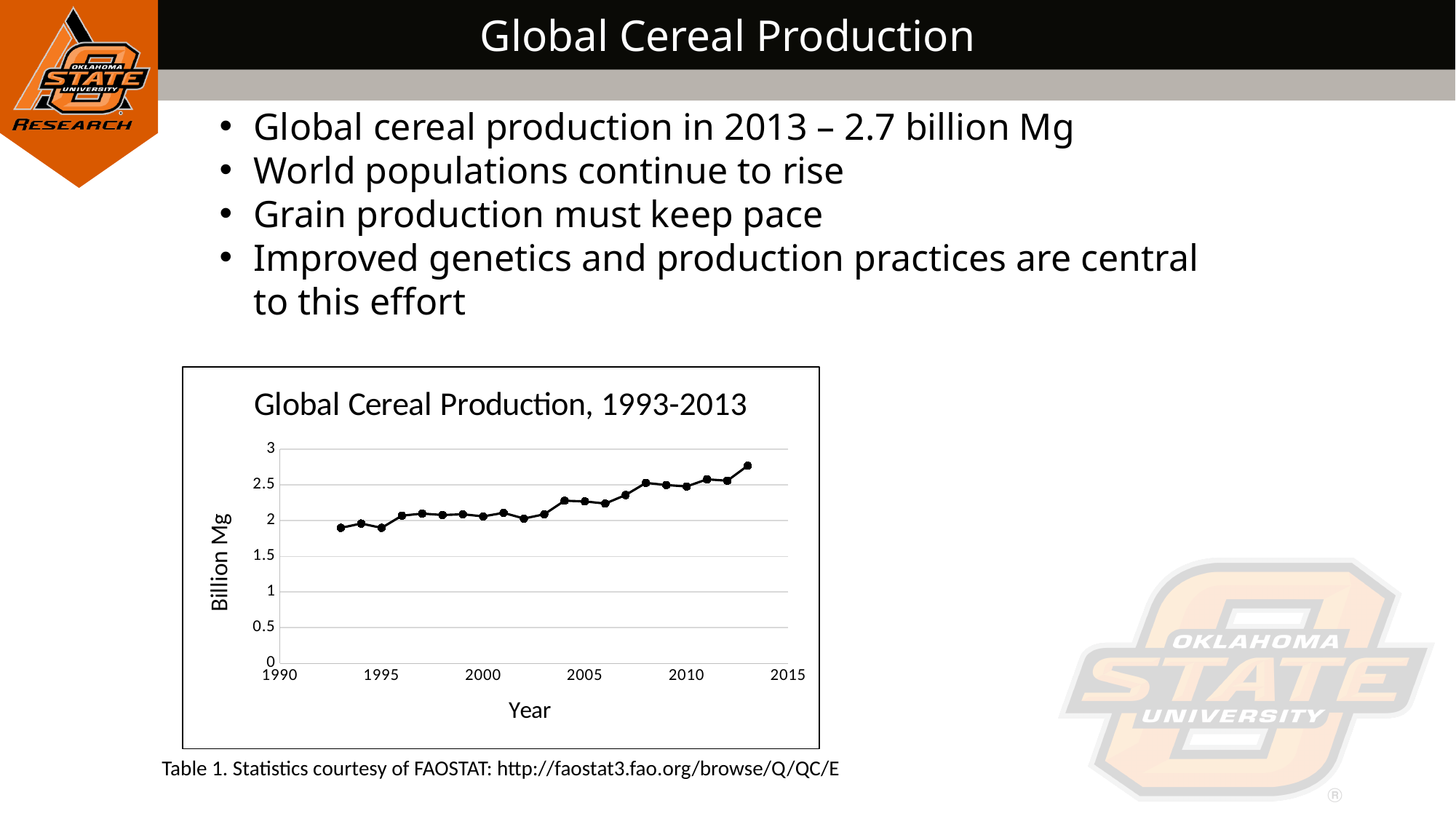
What is the title of the chart? Global Cereal Production, 1993-2013 Which year has the larger value, 2002 or 2004? 2004 Do the values in the chart generally rise or fall from 1993 to 2013? rise What kind of chart is shown on the slide? line chart Is the value for 2007 greater or less than 2.5? less Is the value for 2013 greater or less than 2.5? greater Which year has the larger value, 1993 or 2013? 2013 How many data points are plotted in the chart? 21 Is the value for 1993 greater or less than 2? less Which year has the highest global cereal production in the chart? 2013 What is the label on the y axis of the chart? Billion Mg